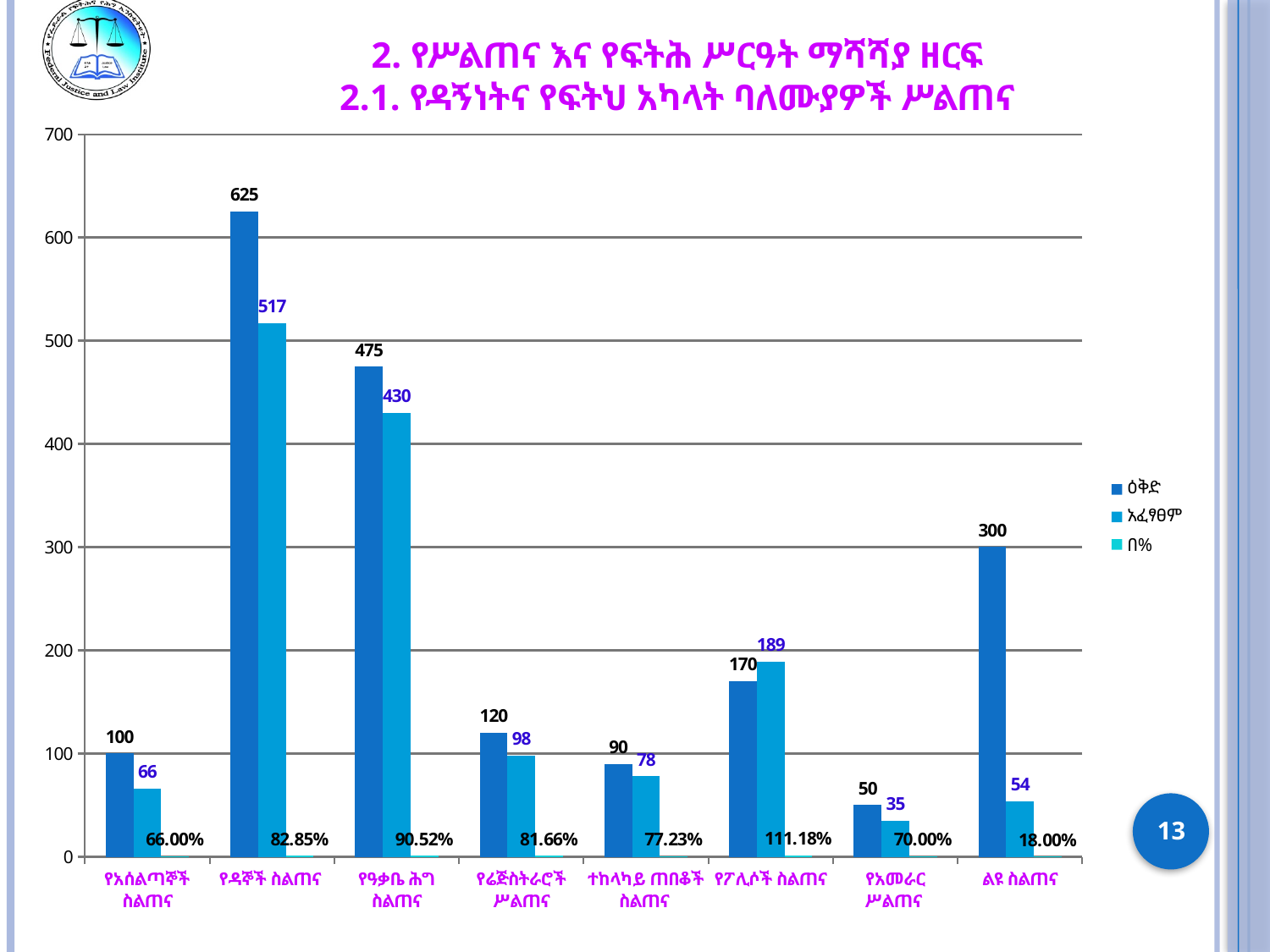
Which is larger for የፖሊሶች ስልጠና, the ዕቅድ value or the አፈፃፀም value? አፈፃፀም What is the ዕቅድ value for የዳኞች ስልጠና? 625 How many categories are shown on the x axis? 8 What is the አፈፃፀም value for ልዩ ስልጠና? 54 Which category has the lowest በ% value? ልዩ ስልጠና Which category has the highest ዕቅድ value? የዳኞች ስልጠና What is the difference between the ዕቅድ and አፈፃፀም values for የዳኞች ስልጠና? 108 What is the አፈፃፀም value for የዓቃቤ ሕግ ስልጠና? 430 How many series does the legend list? 3 What kind of chart is shown on the slide? Bar chart Which category has the lowest ዕቅድ value? የአመራር ሥልጠና What percentage (በ%) is shown for የፖሊሶች ስልጠና? 111.18%